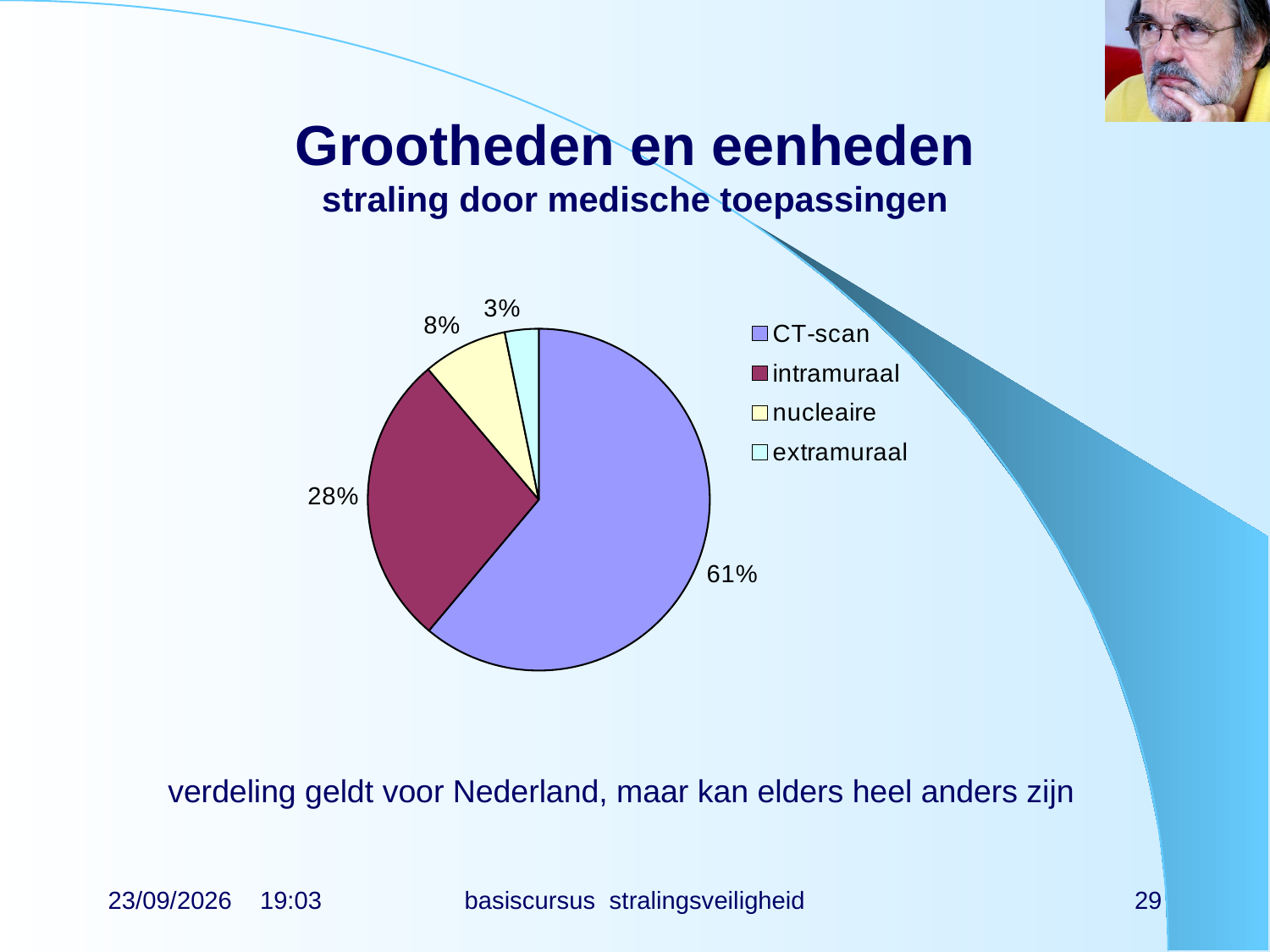
Which is larger, the nucleaire slice or the extramuraal slice? nucleaire Which category has the smallest slice of the pie? extramuraal What share of the pie does CT-scan account for? 61% What is the difference in percentage points between the CT-scan slice and the intramuraal slice? 33 What kind of chart is shown on the slide? pie chart Which category has the largest slice of the pie? CT-scan Which legend entry is shown in red? intramuraal What share of the pie does nucleaire account for? 8% What share of the pie does extramuraal account for? 3% How many categories does the pie chart have? 4 What is the subtitle of the slide above the chart? straling door medische toepassingen